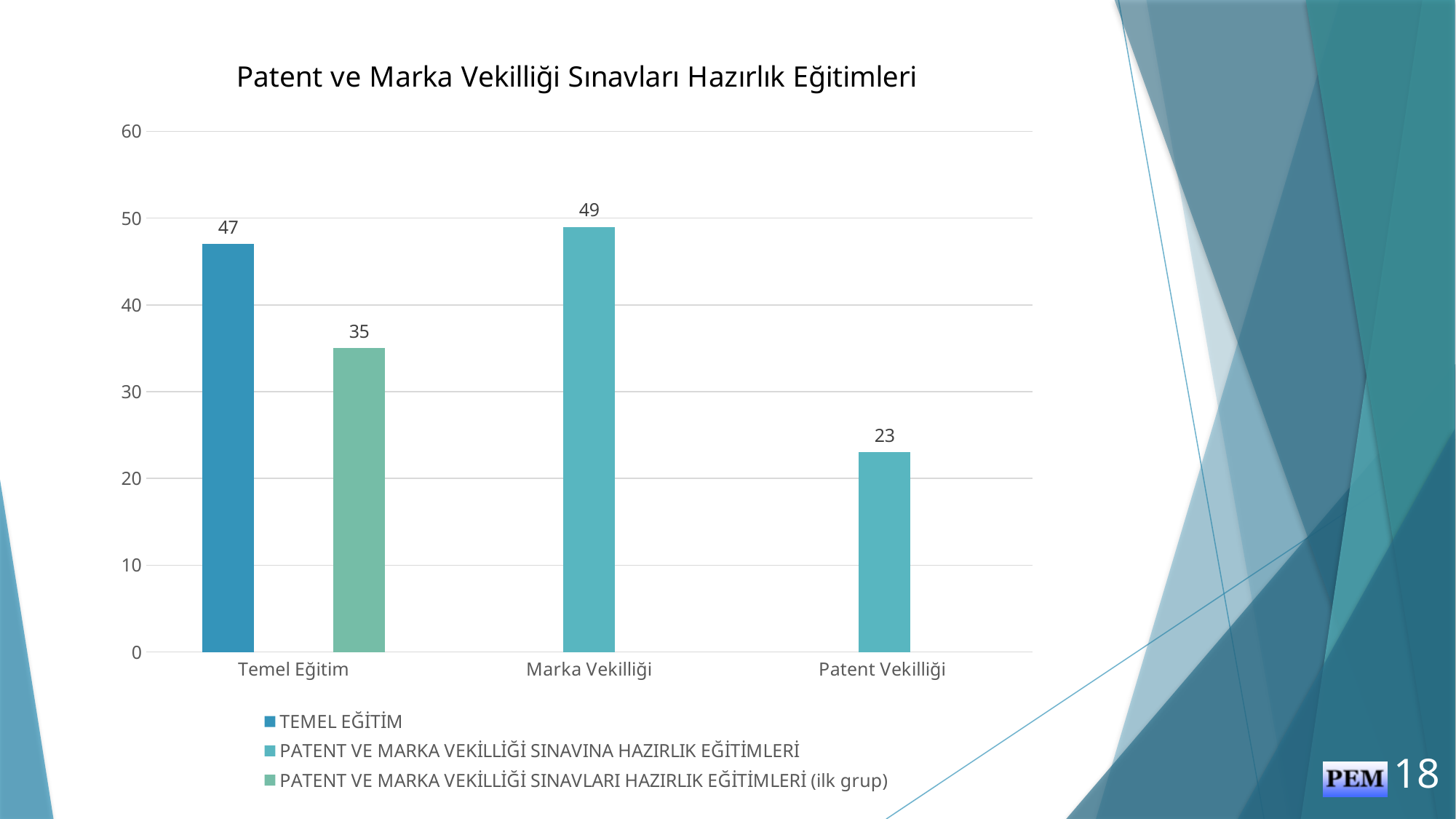
What is the difference between the two bars shown for Temel Eğitim? 12 What is the value of the PATENT VE MARKA VEKİLLİĞİ SINAVINA HAZIRLIK EĞİTİMLERİ bar for Marka Vekilliği? 49 What kind of chart is shown on the slide? Bar chart Which bar has the highest value in the chart? Marka Vekilliği (49) How many series does the legend list? 3 Which is larger: the TEMEL EĞİTİM bar for Temel Eğitim or the PATENT VE MARKA VEKİLLİĞİ SINAVINA HAZIRLIK EĞİTİMLERİ bar for Marka Vekilliği? Marka Vekilliği How many categories are shown on the x axis? 3 What is the value of the TEMEL EĞİTİM bar for Temel Eğitim? 47 Which bar has the lowest value in the chart? Patent Vekilliği (23) What is the value of the PATENT VE MARKA VEKİLLİĞİ SINAVLARI HAZIRLIK EĞİTİMLERİ (ilk grup) bar for Temel Eğitim? 35 What is the value of the PATENT VE MARKA VEKİLLİĞİ SINAVINA HAZIRLIK EĞİTİMLERİ bar for Patent Vekilliği? 23 What is the difference between the Marka Vekilliği value (49) and the Patent Vekilliği value (23)? 26